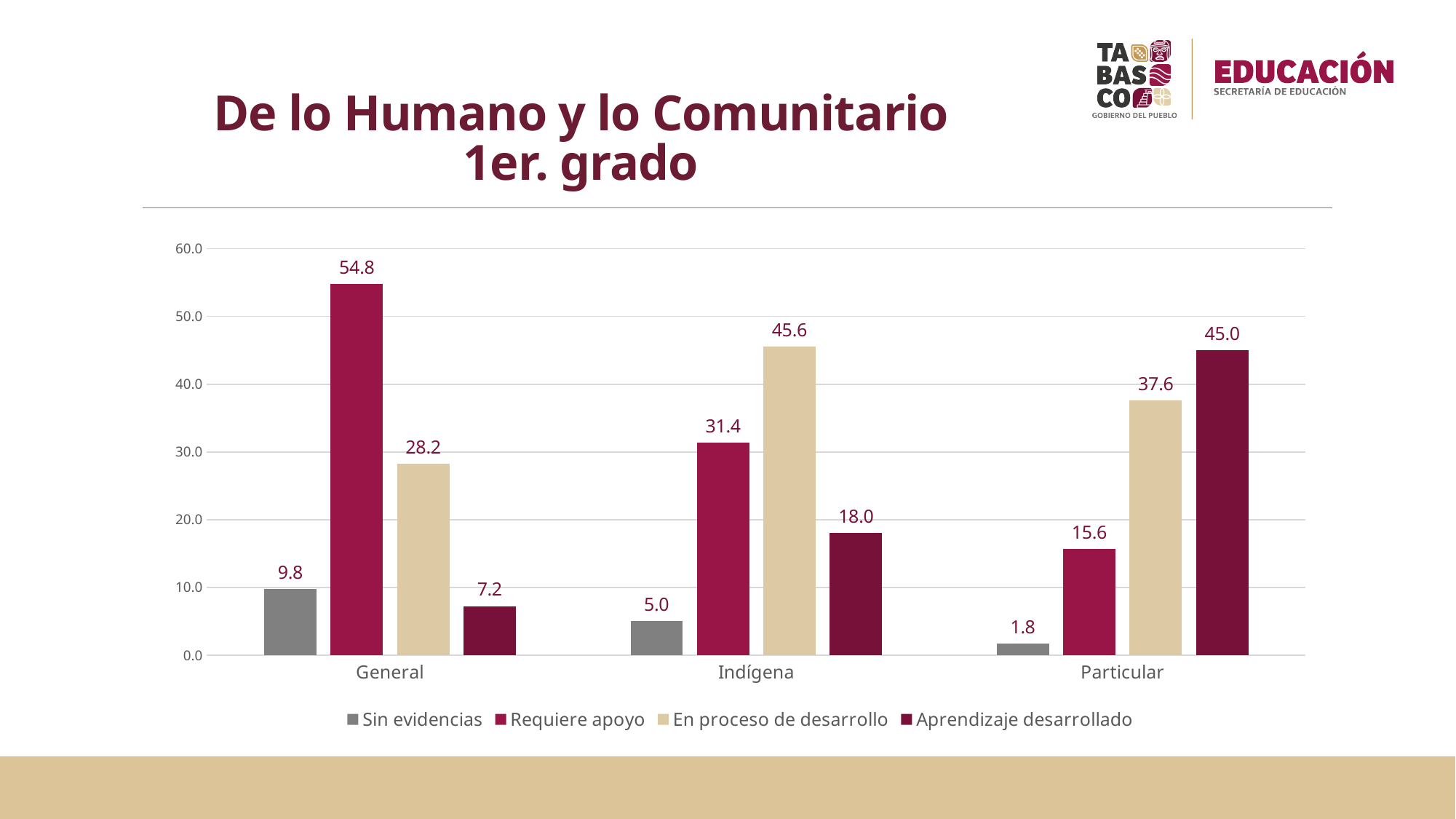
What is the value for "En proceso de desarrollo" in the Indígena category? 45.6 How many series does the legend list? 4 What kind of chart is shown on the slide? Bar chart What is the value for "Aprendizaje desarrollado" in the Indígena category? 18.0 What is the value for "Requiere apoyo" in the General category? 54.8 What is the value for "Sin evidencias" in the Particular category? 1.8 What is the difference between "Requiere apoyo" and "En proceso de desarrollo" in the General category? 26.6 How many categories are shown on the x axis? 3 Which is larger in the Particular category: "En proceso de desarrollo" or "Aprendizaje desarrollado"? Aprendizaje desarrollado Which category has the lowest value for "Sin evidencias"? Particular Which category has the highest value for "Aprendizaje desarrollado"? Particular Is the value for "Requiere apoyo" in the Indígena category greater or less than 30.0? greater